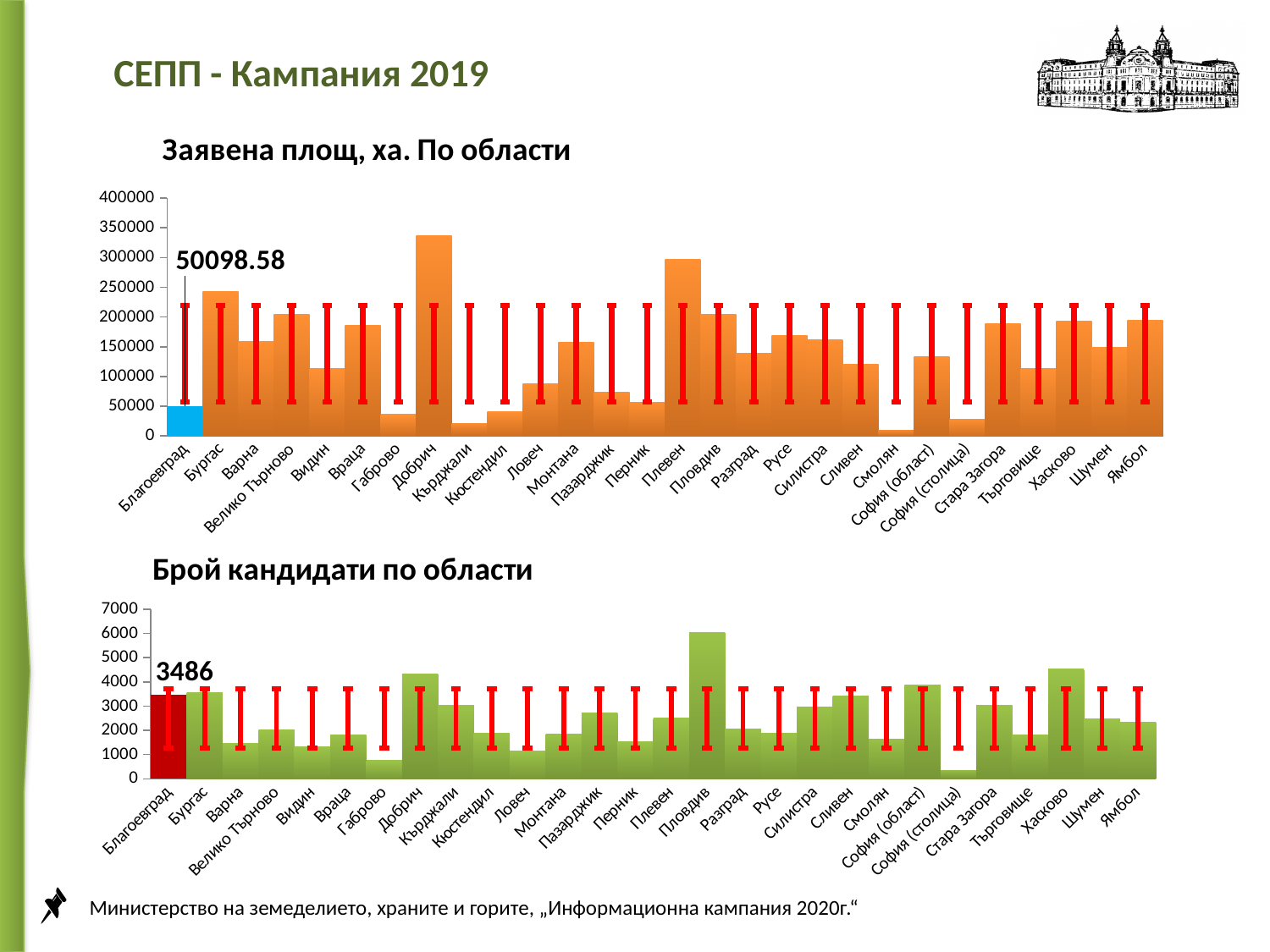
In the chart titled "Брой кандидати по области", what is the value for Благоевград? 3486 In the chart titled "Заявена площ, ха. По области", is the value for Добрич greater or less than 300000? greater In the chart titled "Заявена площ, ха. По области", what is the value for Благоевград? 50098.58 In the chart titled "Заявена площ, ха. По области", is the value for Габрово greater or less than 50000? less In the chart titled "Заявена площ, ха. По области", which region has the highest value? Добрич How many regions are shown in the chart titled "Брой кандидати по области"? 28 In the chart titled "Брой кандидати по области", which region has the highest value? Пловдив In the chart titled "Заявена площ, ха. По области", which region has the lowest value? Смолян What kind of chart is the chart titled "Заявена площ, ха. По области"? bar chart In the chart titled "Брой кандидати по области", which is larger, the value for Пловдив or the value for Хасково? Пловдив In the chart titled "Брой кандидати по области", which region has the lowest value? София (столица) In the chart titled "Брой кандидати по области", is the value for Пловдив greater or less than 5000? greater